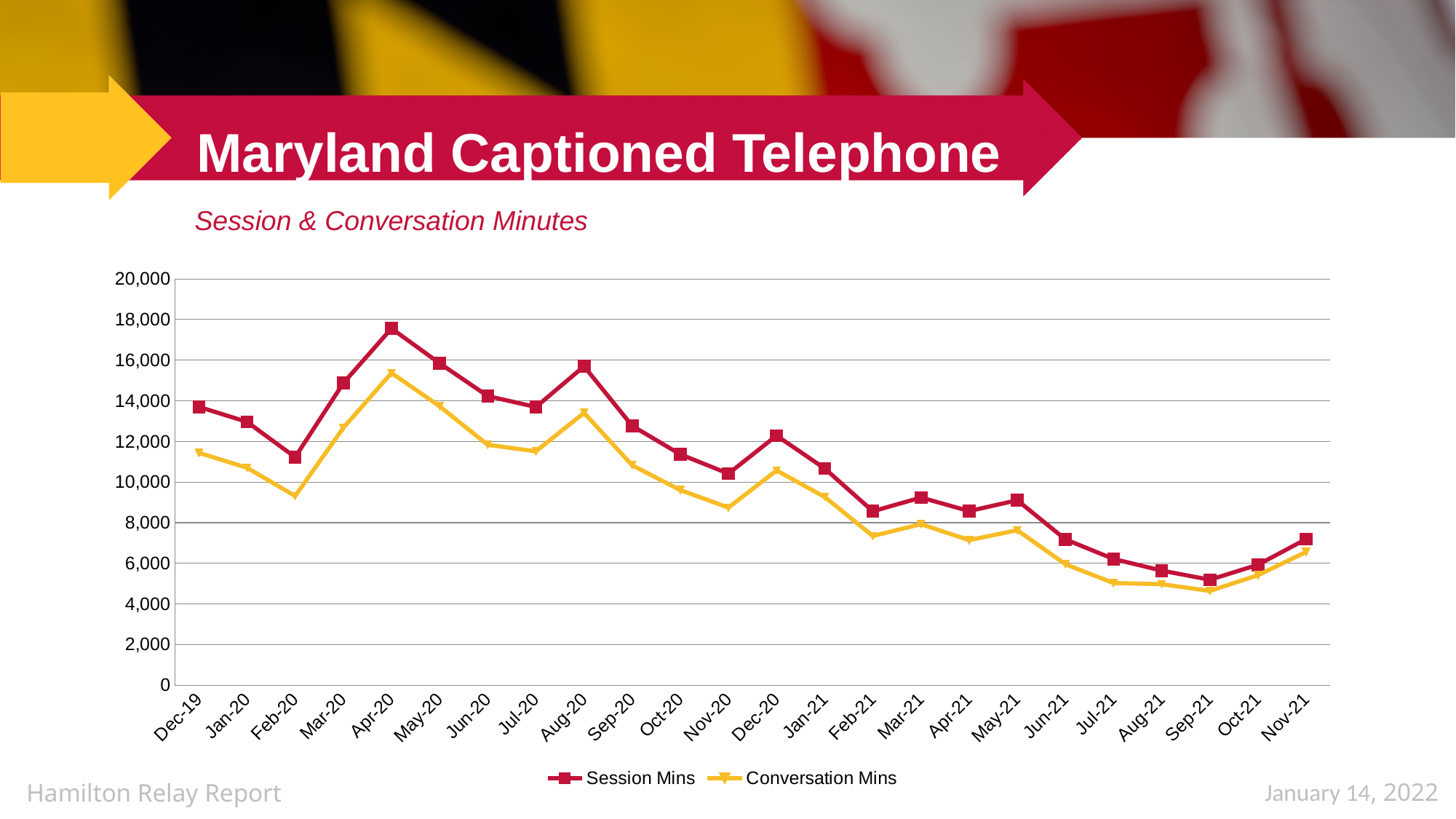
Which is larger for Session Mins: Aug-20 or Dec-20? Aug-20 Is the value for Session Mins in Sep-21 greater or less than 6,000? less How many series does the legend list? 2 Overall, do the Session Mins values rise or fall from Dec-19 to Nov-21? Fall Is the value for Conversation Mins in Feb-20 greater or less than 10,000? less In which month does Session Mins reach its lowest value? Sep-21 What kind of chart is shown on the slide? Line chart How many months are plotted along the x axis? 24 What colour is the Conversation Mins line? Yellow Is the value for Session Mins in Apr-20 greater or less than 16,000? greater In which month does Conversation Mins reach its highest value? Apr-20 In which month does Session Mins reach its highest value? Apr-20